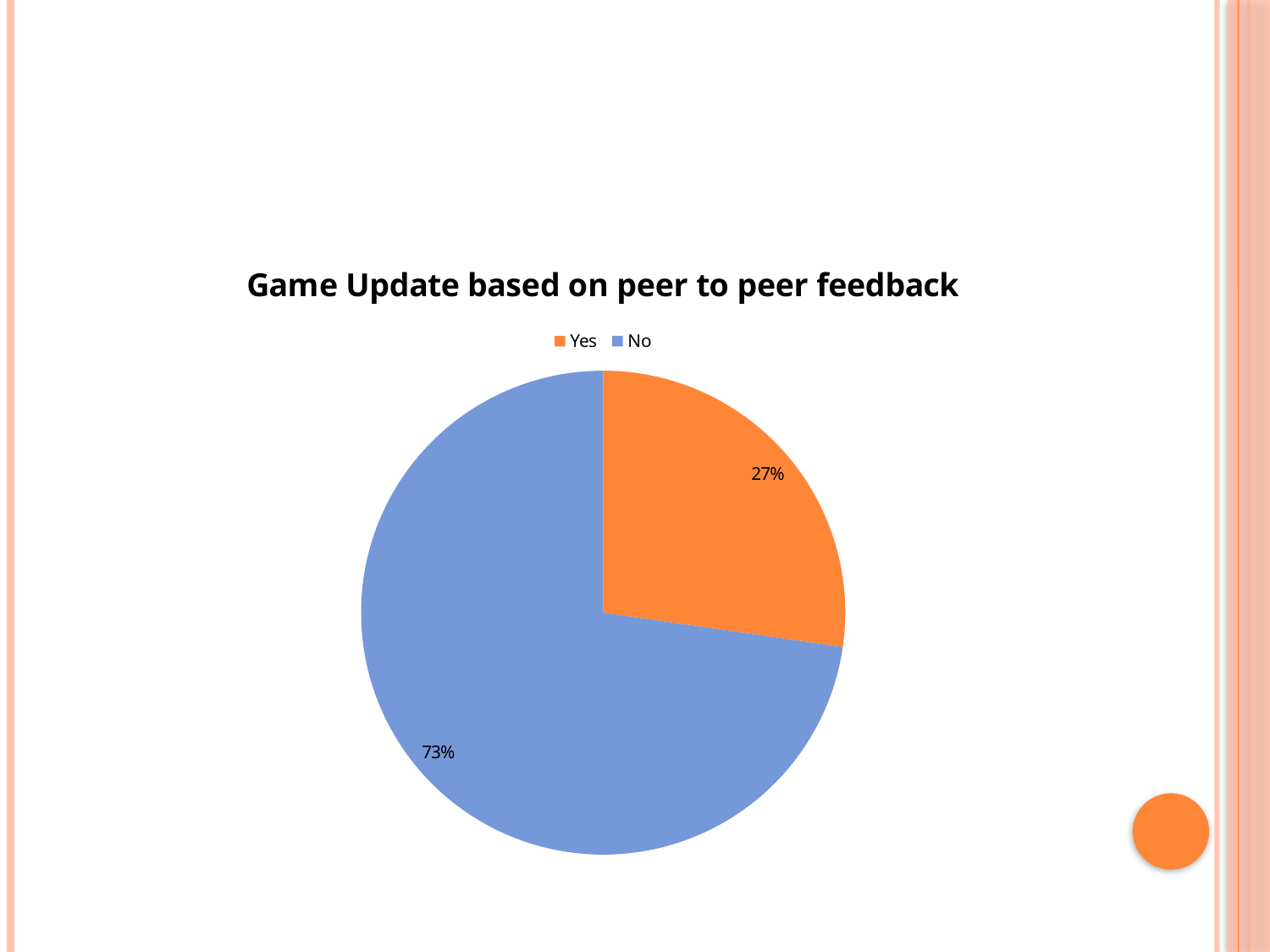
What is the title of the chart? Game Update based on peer to peer feedback Which category has the largest slice of the pie? No What share of the pie does the "No" slice represent? 73% What colour is the "Yes" slice? orange How many slices does the pie chart have? 2 What share of the pie does the "Yes" slice represent? 27% What kind of chart is shown on the slide? pie chart How many entries does the legend list? 2 Which category has the smallest slice of the pie? Yes What is the difference in percentage points between the "No" and "Yes" slices? 46 Which is larger, the "Yes" slice or the "No" slice? No